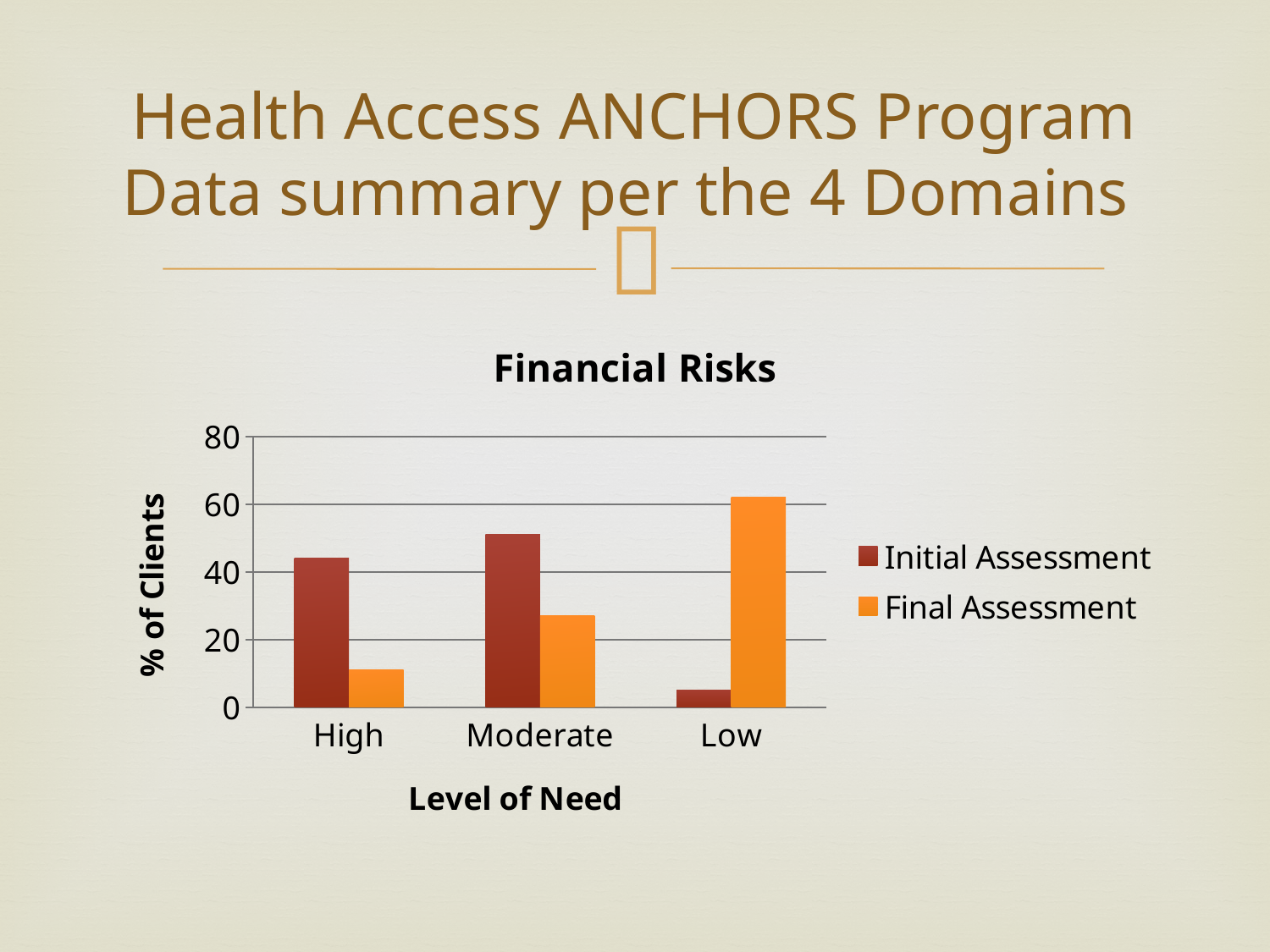
Is the Initial Assessment value for High greater or less than 40? greater Which category has the lowest Final Assessment value? High Which category has the lowest Initial Assessment value? Low How many categories are shown on the x axis? 3 What is the title of the chart? Financial Risks For the High category, which is larger: Initial Assessment or Final Assessment? Initial Assessment How many series does the legend list? 2 For the Low category, which is larger: Initial Assessment or Final Assessment? Final Assessment What kind of chart is shown on the slide? bar chart Which category has the highest Initial Assessment value? Moderate Which category has the highest Final Assessment value? Low